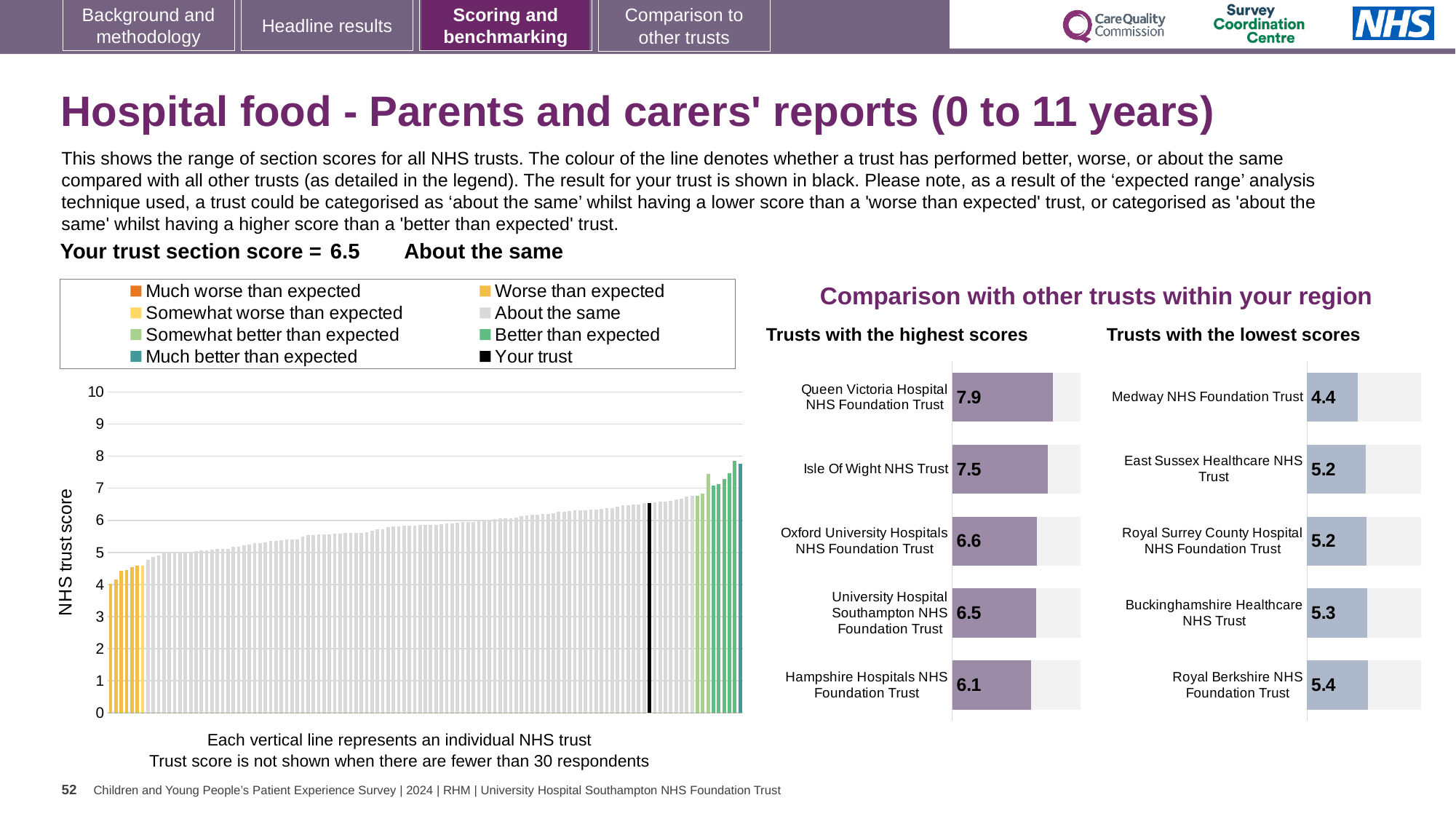
In the 'Trusts with the highest scores' chart, what is the score for Hampshire Hospitals NHS Foundation Trust? 6.1 What type of chart is the large chart on the left showing NHS trust scores? Bar chart How many entries does the legend of the large chart on the left list? 8 In the 'Trusts with the lowest scores' chart, which trust has the lowest score? Medway NHS Foundation Trust In the large chart on the left, is the value of the black bar (your trust) greater or less than 6? greater How many trusts are listed in the 'Trusts with the lowest scores' chart? 5 In the 'Trusts with the highest scores' chart, what is the score for Queen Victoria Hospital NHS Foundation Trust? 7.9 In the 'Trusts with the lowest scores' chart, what is the score for Medway NHS Foundation Trust? 4.4 In the 'Trusts with the lowest scores' chart, which has the larger score: Royal Berkshire NHS Foundation Trust or Medway NHS Foundation Trust? Royal Berkshire NHS Foundation Trust In the large chart on the left, do the trust scores rise or fall from left to right? Rise In the 'Trusts with the highest scores' chart, what is the difference between the scores of Queen Victoria Hospital NHS Foundation Trust and Hampshire Hospitals NHS Foundation Trust? 1.8 In the 'Trusts with the highest scores' chart, which trust has the highest score? Queen Victoria Hospital NHS Foundation Trust